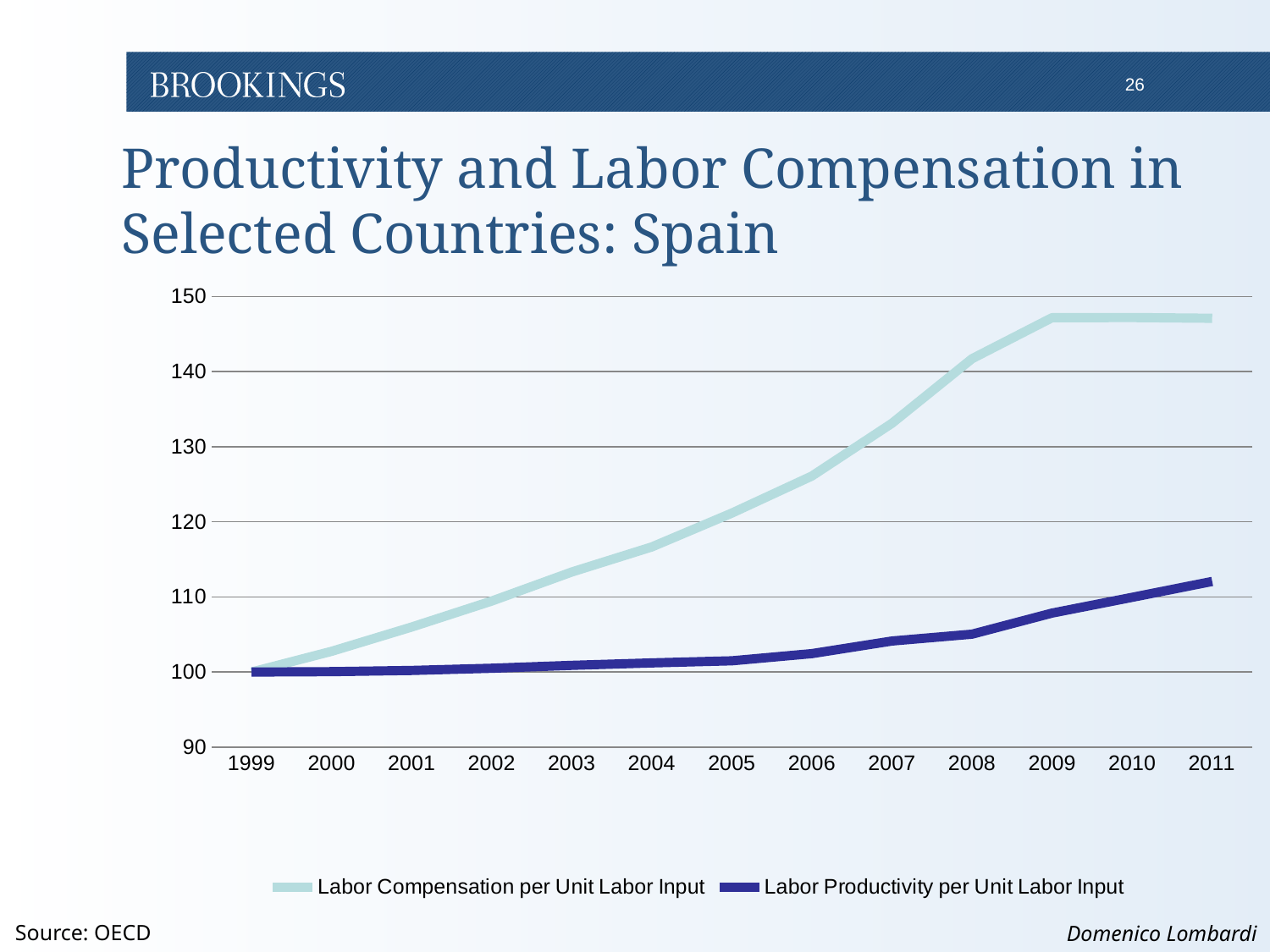
What is the value of Labor Compensation per Unit Labor Input in 1999? 100 What is the value of Labor Productivity per Unit Labor Input in 1999? 100 What kind of chart is shown on the slide? line chart In which year is Labor Productivity per Unit Labor Input highest? 2011 Does Labor Compensation per Unit Labor Input rise or fall from 1999 to 2009? rise Is the value for Labor Productivity per Unit Labor Input in 2008 greater or less than 110? less How many series does the legend list? 2 In 2011, which series has the higher value: Labor Compensation per Unit Labor Input or Labor Productivity per Unit Labor Input? Labor Compensation per Unit Labor Input Is the value for Labor Compensation per Unit Labor Input in 2011 greater or less than 140? greater Is the value for Labor Productivity per Unit Labor Input in 2011 greater or less than 120? less How many years are shown on the x axis? 13